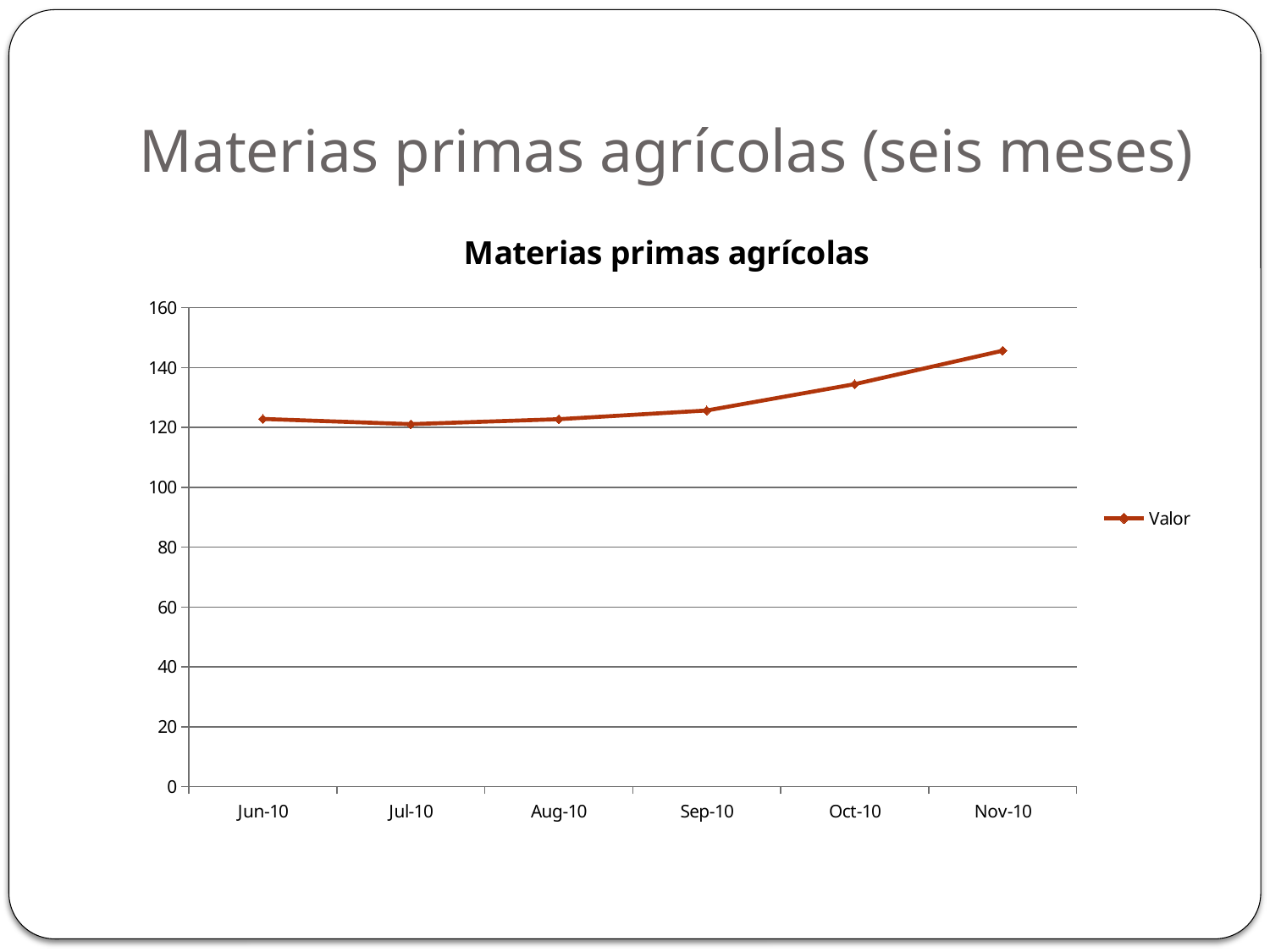
What kind of chart is shown on the slide? line chart Which month has the highest value? Nov-10 Is the value for Sep-10 greater or less than 120? greater Do the values generally rise or fall from Jul-10 to Nov-10? rise Is the value for Nov-10 greater or less than 140? greater How many series does the legend list? 1 What is the name of the series shown in the legend? Valor Which is larger, the value for Oct-10 or the value for Sep-10? Oct-10 What is the title of the chart? Materias primas agrícolas Is the value for Oct-10 greater or less than 140? less How many months are plotted on the x axis? 6